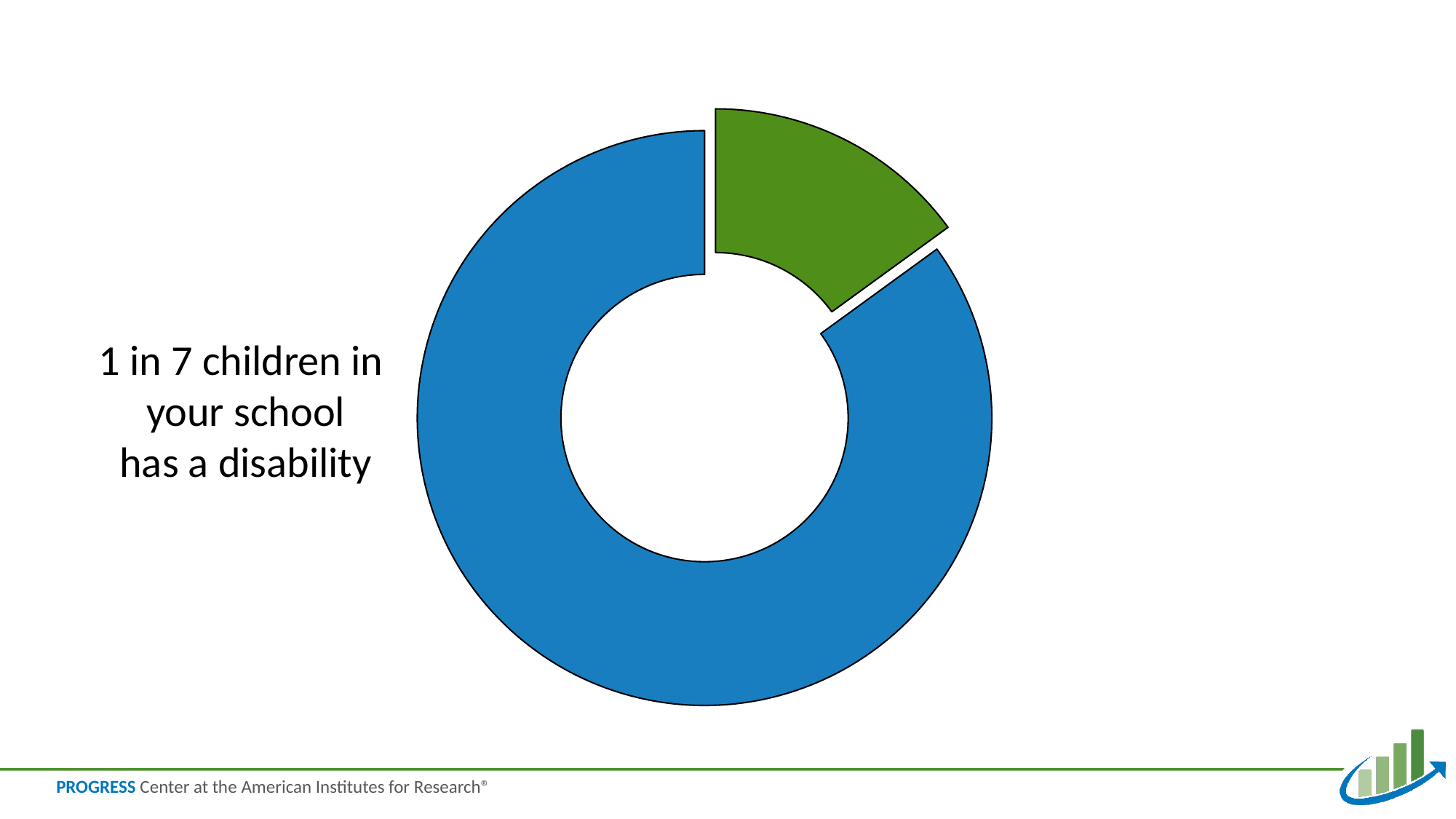
According to the text next to the chart, what proportion of children in your school has a disability? 1 in 7 Which colour slice is the smallest in the doughnut chart? Green Which slice of the doughnut chart is larger, the blue one or the green one? The blue one What kind of chart is shown on the slide? Doughnut (pie) chart Which colour slice is the largest in the doughnut chart? Blue Is the blue slice's share of the doughnut chart greater or less than 50%? greater Is the green slice's share of the doughnut chart greater or less than 50%? less How many slices does the doughnut chart have? 2 Which slice of the doughnut chart is pulled out (exploded) from the ring? The green slice